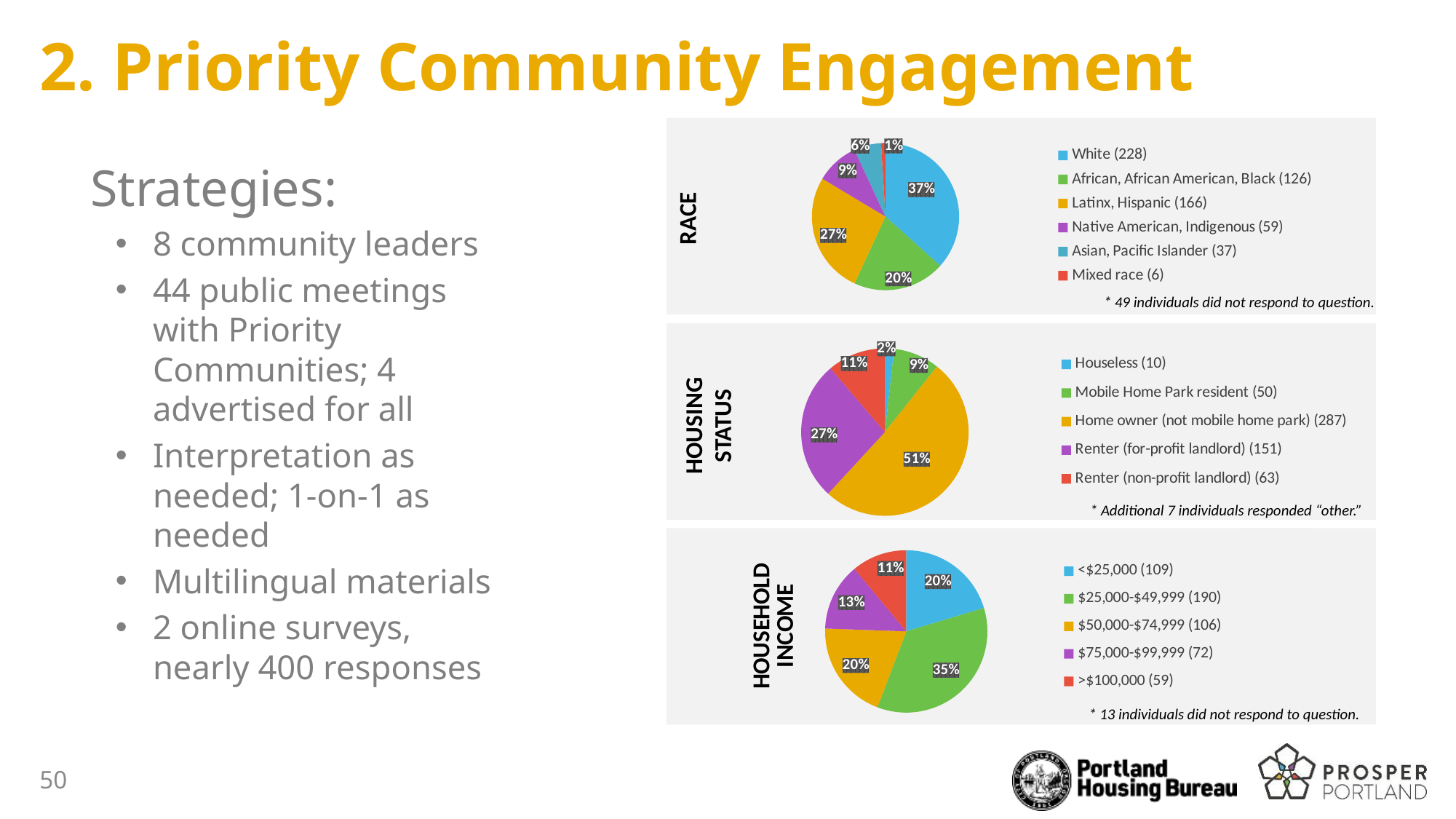
In the RACE chart, how many respondents are listed for Latinx, Hispanic in the legend? 166 In the HOUSING STATUS chart, which is larger, the Houseless slice or the Mobile Home Park resident slice? Mobile Home Park resident In the HOUSEHOLD INCOME chart, what share of the pie is $25,000-$49,999? 35% According to the note under the RACE chart, how many individuals did not respond to the question? 49 In the RACE chart, how many categories does the legend list? 6 In the HOUSEHOLD INCOME chart, which category has the smallest slice? >$100,000 In the HOUSING STATUS chart, which category has the largest slice? Home owner (not mobile home park) In the HOUSING STATUS chart, what share of the pie is Home owner (not mobile home park)? 51% In the RACE chart, which category has the smallest slice? Mixed race In the HOUSING STATUS chart, what is the difference in percentage points between Renter (for-profit landlord) and Renter (non-profit landlord)? 16 What type of chart is used for HOUSEHOLD INCOME? Pie chart In the RACE chart, what share of the pie is White? 37%